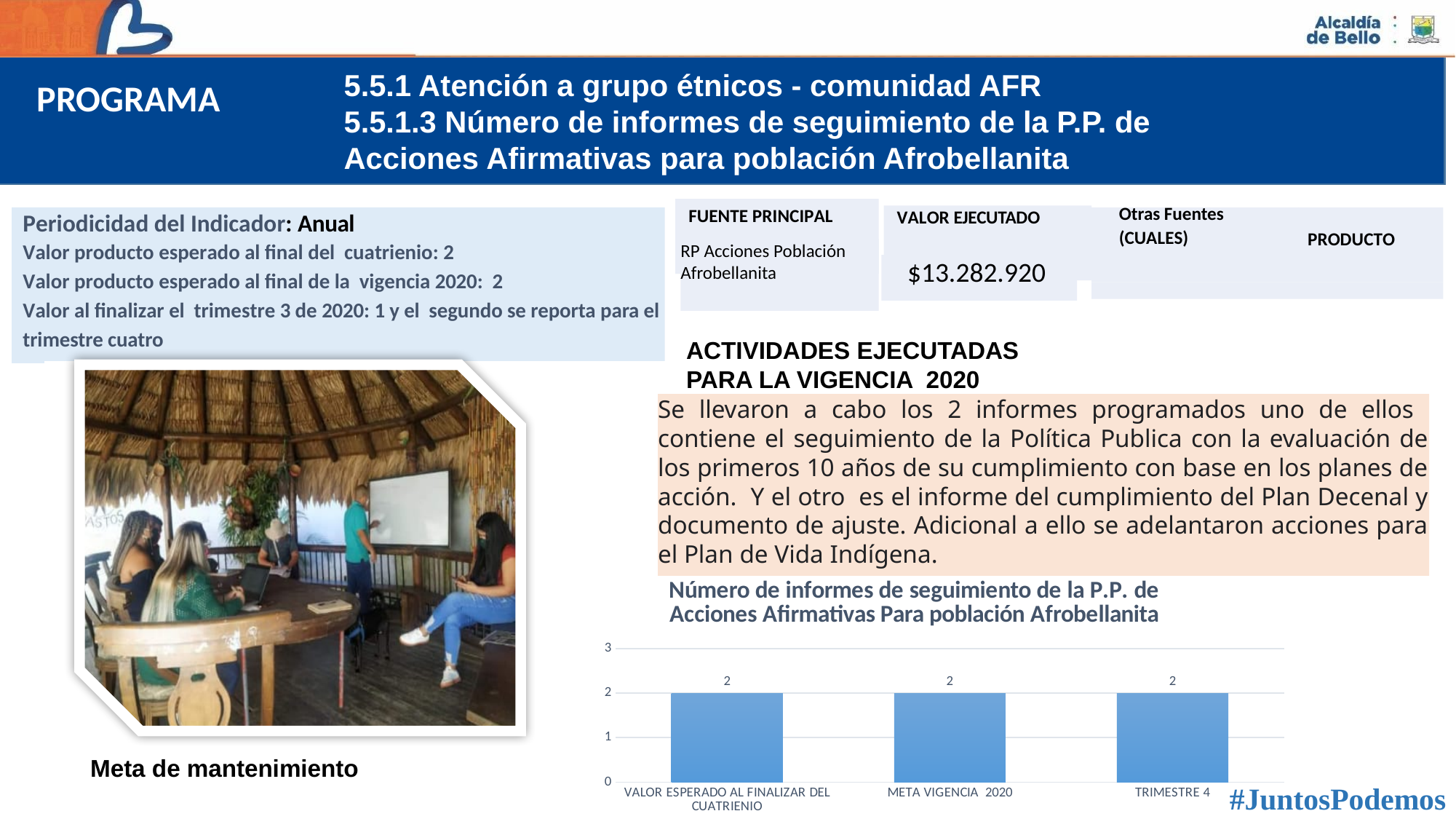
Do the values rise, fall, or stay the same across the categories on the x axis? Stay the same Is the value for META VIGENCIA 2020 greater or less than 3? less What is the value for META VIGENCIA 2020 in the chart? 2 What kind of chart is shown on the slide? Bar chart How many categories are shown on the x axis of the chart? 3 What is the difference between the value for META VIGENCIA 2020 and the value for TRIMESTRE 4? 0 What is the highest value shown on the chart's y axis? 3 Is the value for TRIMESTRE 4 greater or less than 1? greater What is the value for TRIMESTRE 4 in the chart? 2 What is the value for VALOR ESPERADO AL FINALIZAR DEL CUATRIENIO in the chart? 2 What is the title of the chart? Número de informes de seguimiento de la P.P. de Acciones Afirmativas Para población Afrobellanita